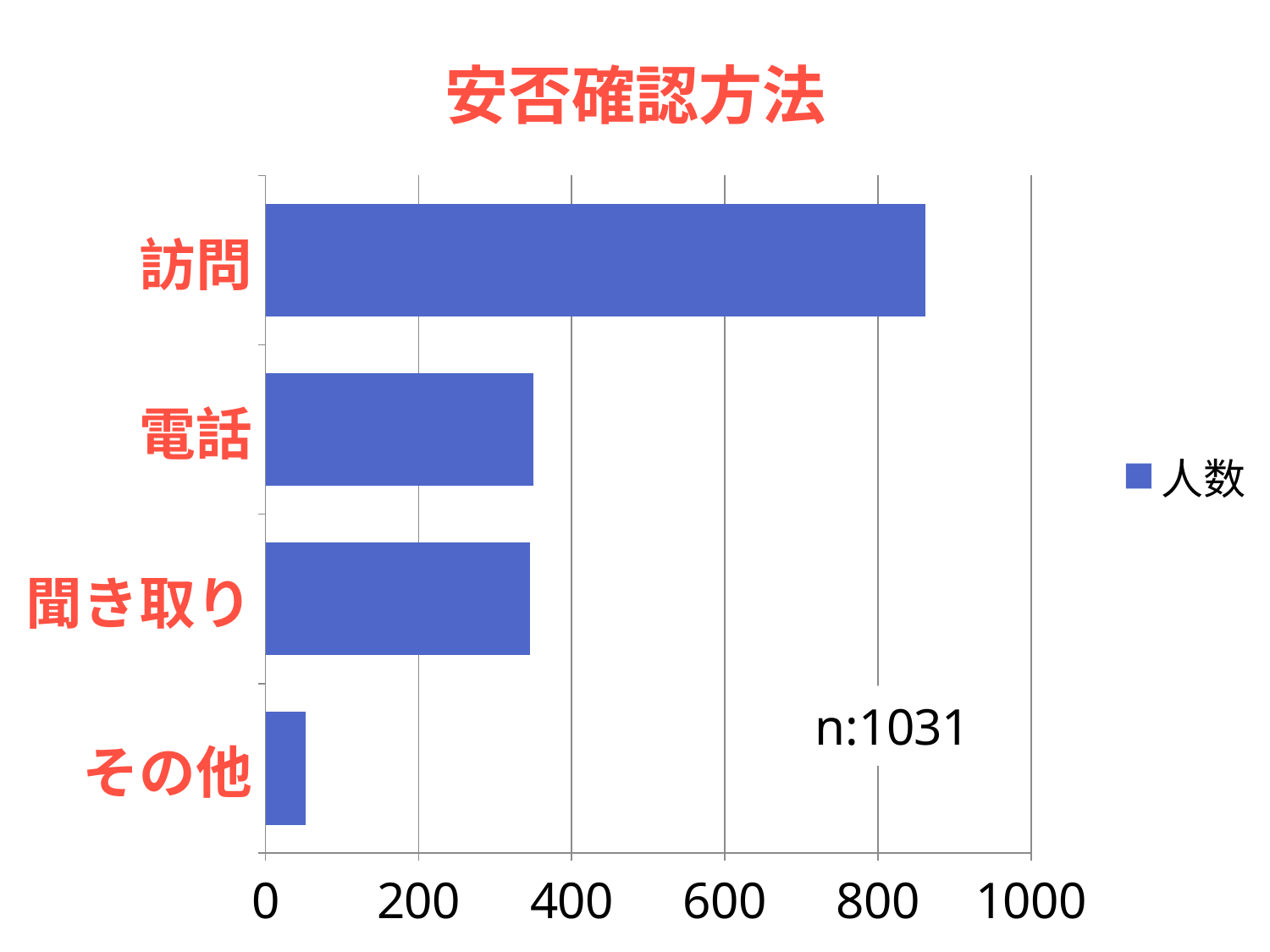
Which category has the highest value? 訪問 Is the value for 訪問 greater or less than 800? greater Is the value for 聞き取り greater or less than 200? greater Which category has the lowest value? その他 Which is larger, the value for 訪問 or the value for 電話? 訪問 What is the title of the chart? 安否確認方法 What kind of chart is shown on the slide? bar chart Is the value for 電話 greater or less than 400? less How many categories are shown in the chart? 4 What is the name of the series shown in the legend? 人数 How many series does the legend list? 1